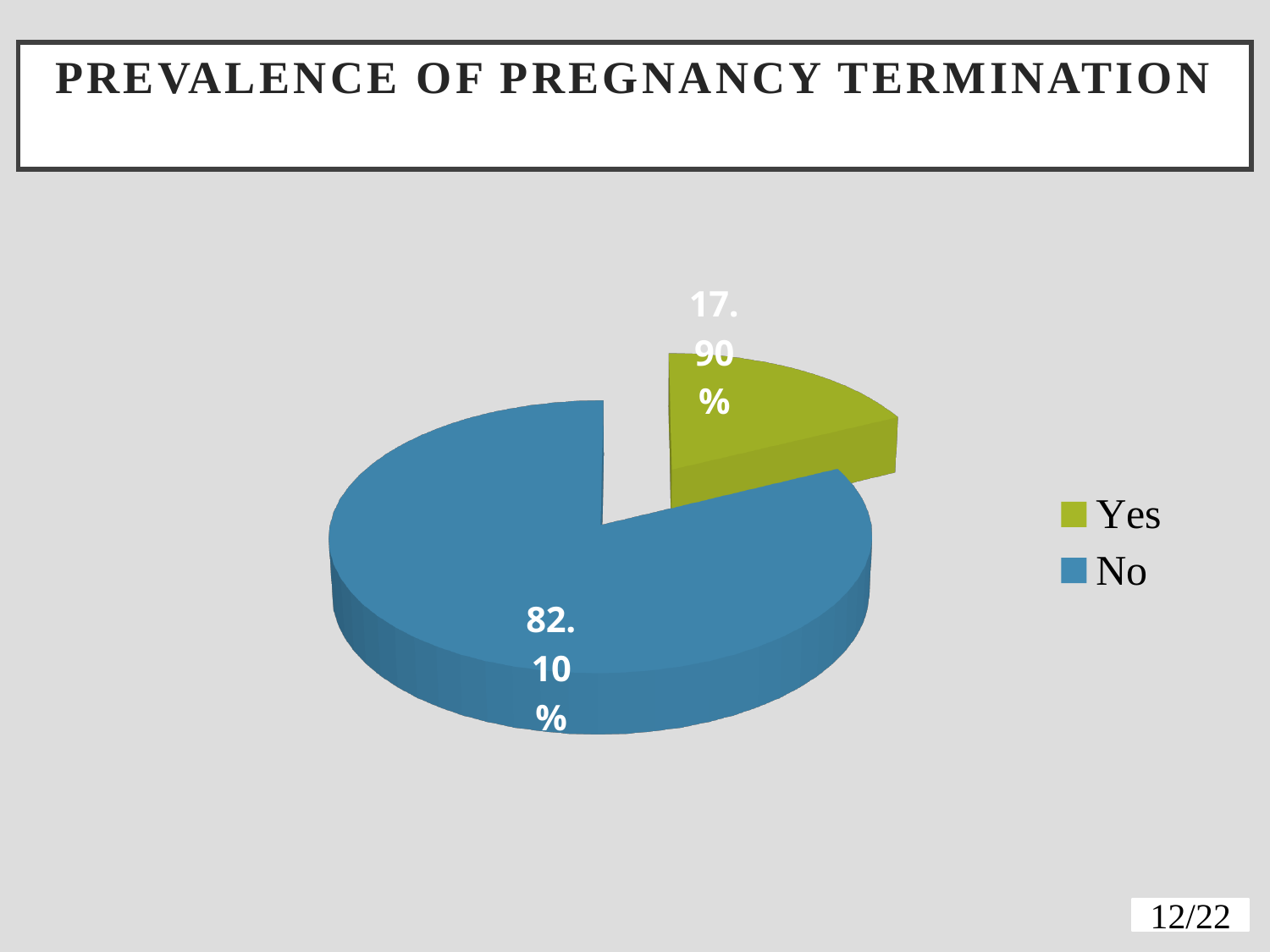
How many entries does the legend list? 2 What percentage of the pie is labelled "No"? 82.10% What colour is the "Yes" slice of the pie? green What is the title of the slide containing the chart? PREVALENCE OF PREGNANCY TERMINATION What kind of chart is shown on the slide? pie chart Which category has the smallest share of the pie? Yes Which category has the largest share of the pie? No Which is larger, the share for "Yes" or the share for "No"? No How many categories does the pie chart show? 2 What percentage of the pie is labelled "Yes"? 17.90% What is the difference in percentage points between the "No" share and the "Yes" share? 64.20